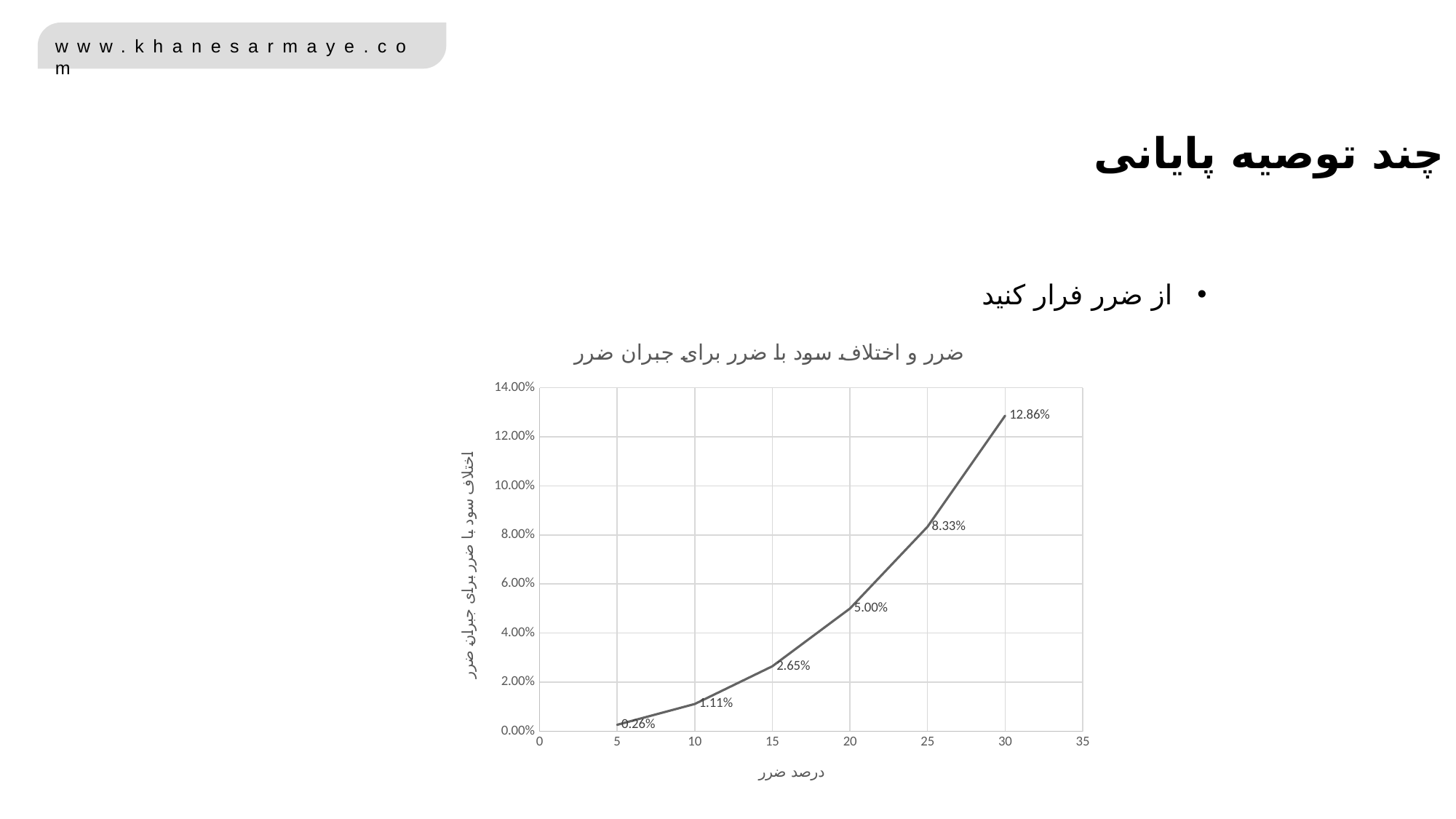
What is the value plotted at a loss percentage of 20? 5.00% Is the value at loss percentage 25 greater or less than 10.00%? less What is the value plotted at a loss percentage (درصد ضرر) of 30? 12.86% What is the value plotted at a loss percentage of 5? 0.26% What kind of chart is shown on the slide? line chart At which loss percentage on the x axis is the plotted value lowest? 5 Which is larger: the value at loss percentage 10 or the value at loss percentage 25? 25 What is the value plotted at a loss percentage of 15? 2.65% Do the plotted values rise or fall as the loss percentage increases along the x axis? rise What is the difference between the values at loss percentages 25 and 20? 3.33% How many data points are plotted on the line? 6 At which loss percentage on the x axis is the plotted value highest? 30